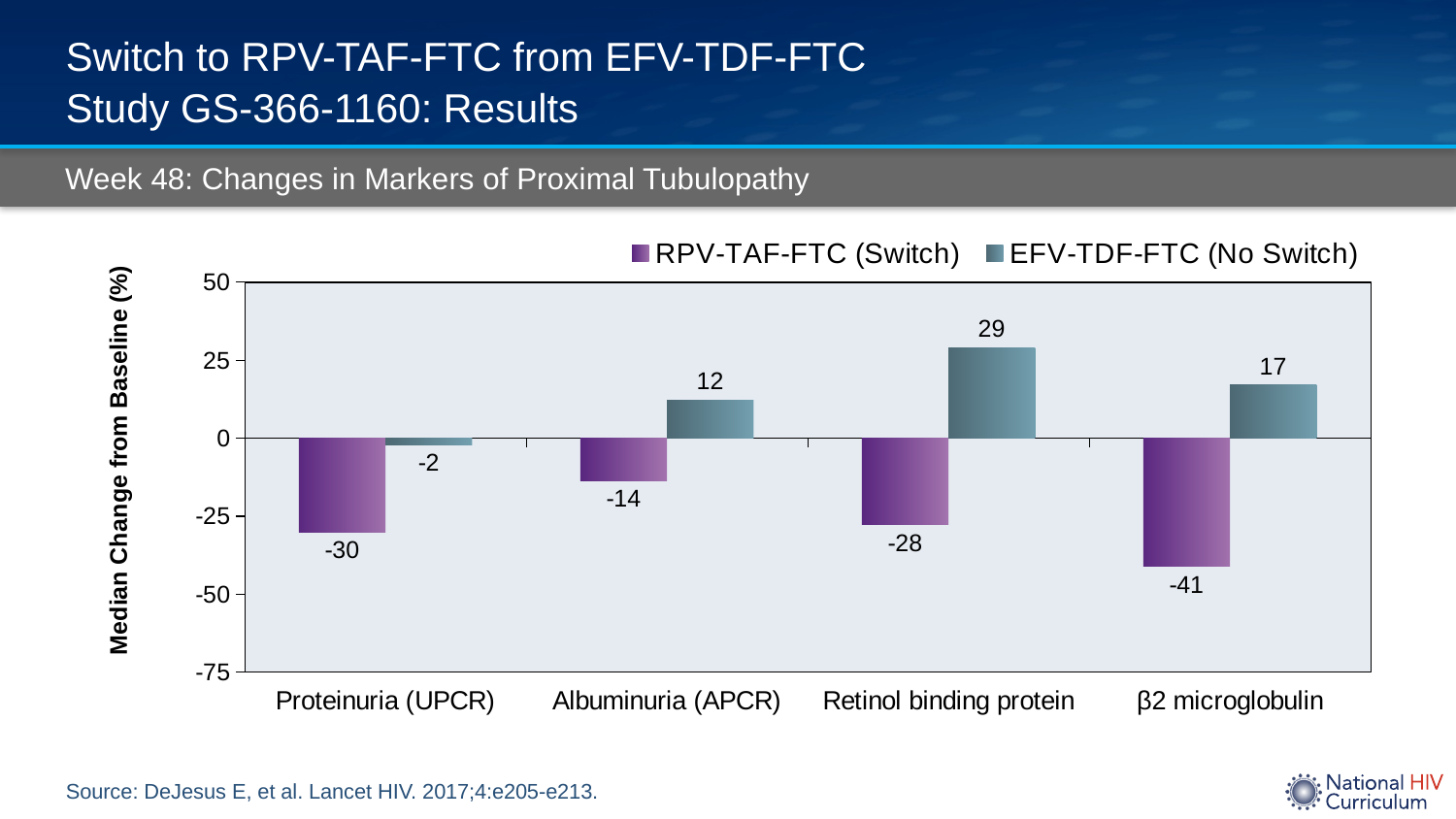
Which is larger, the EFV-TDF-FTC (No Switch) value for β2 microglobulin or for Albuminuria (APCR)? β2 microglobulin Which category has the lowest value for RPV-TAF-FTC (Switch)? β2 microglobulin What kind of chart is shown on the slide? Bar chart Which category has the highest value for EFV-TDF-FTC (No Switch)? Retinol binding protein What is the label of the y axis? Median Change from Baseline (%) What is the median change from baseline for EFV-TDF-FTC (No Switch) in Retinol binding protein? 29 How many series does the legend list? 2 What is the difference between the EFV-TDF-FTC (No Switch) and RPV-TAF-FTC (Switch) values for Retinol binding protein? 57 How many categories are shown on the x axis? 4 What is the value for EFV-TDF-FTC (No Switch) in Albuminuria (APCR)? 12 What is the median change from baseline for RPV-TAF-FTC (Switch) in Proteinuria (UPCR)? -30 What is the value for RPV-TAF-FTC (Switch) in β2 microglobulin? -41